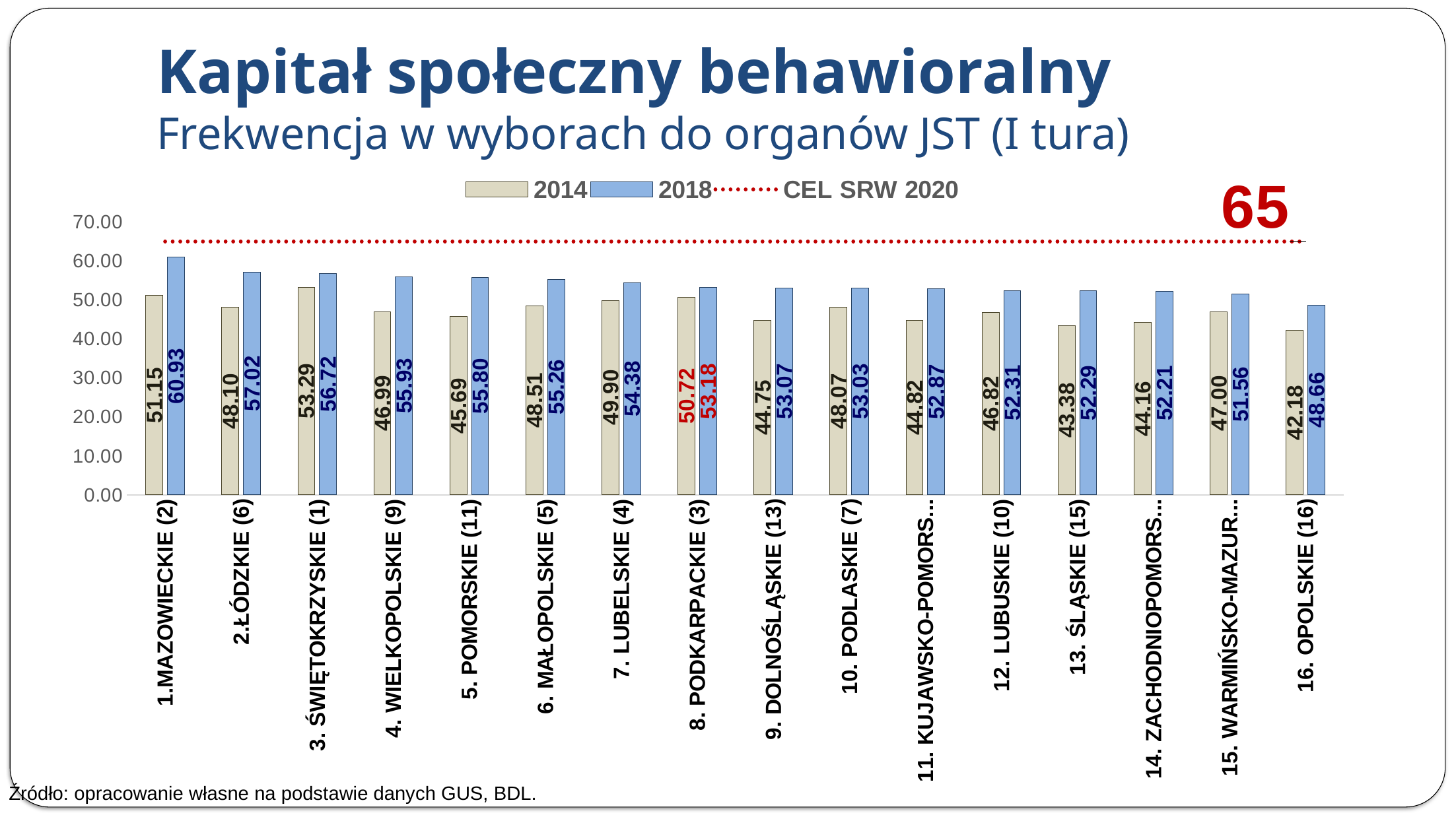
How many entries does the legend list? 3 Which region has the lowest 2014 value? 16. OPOLSKIE (16) What kind of chart is shown on the slide? bar chart What is the 2018 value for 8. PODKARPACKIE? 53.18 Is the 2018 value for 16. OPOLSKIE greater or less than 50.00? less What value does the dotted CEL SRW 2020 target line mark? 65 What is the 2014 value for 5. POMORSKIE? 45.69 Which is larger for 13. ŚLĄSKIE: the 2014 value or the 2018 value? 2018 How many regions are shown on the x axis? 16 Which region has the highest 2018 value? 1.MAZOWIECKIE (2) What is the difference between the 2018 and 2014 values for 1.MAZOWIECKIE? 9.78 Which region has the highest 2014 value? 3. ŚWIĘTOKRZYSKIE (1)